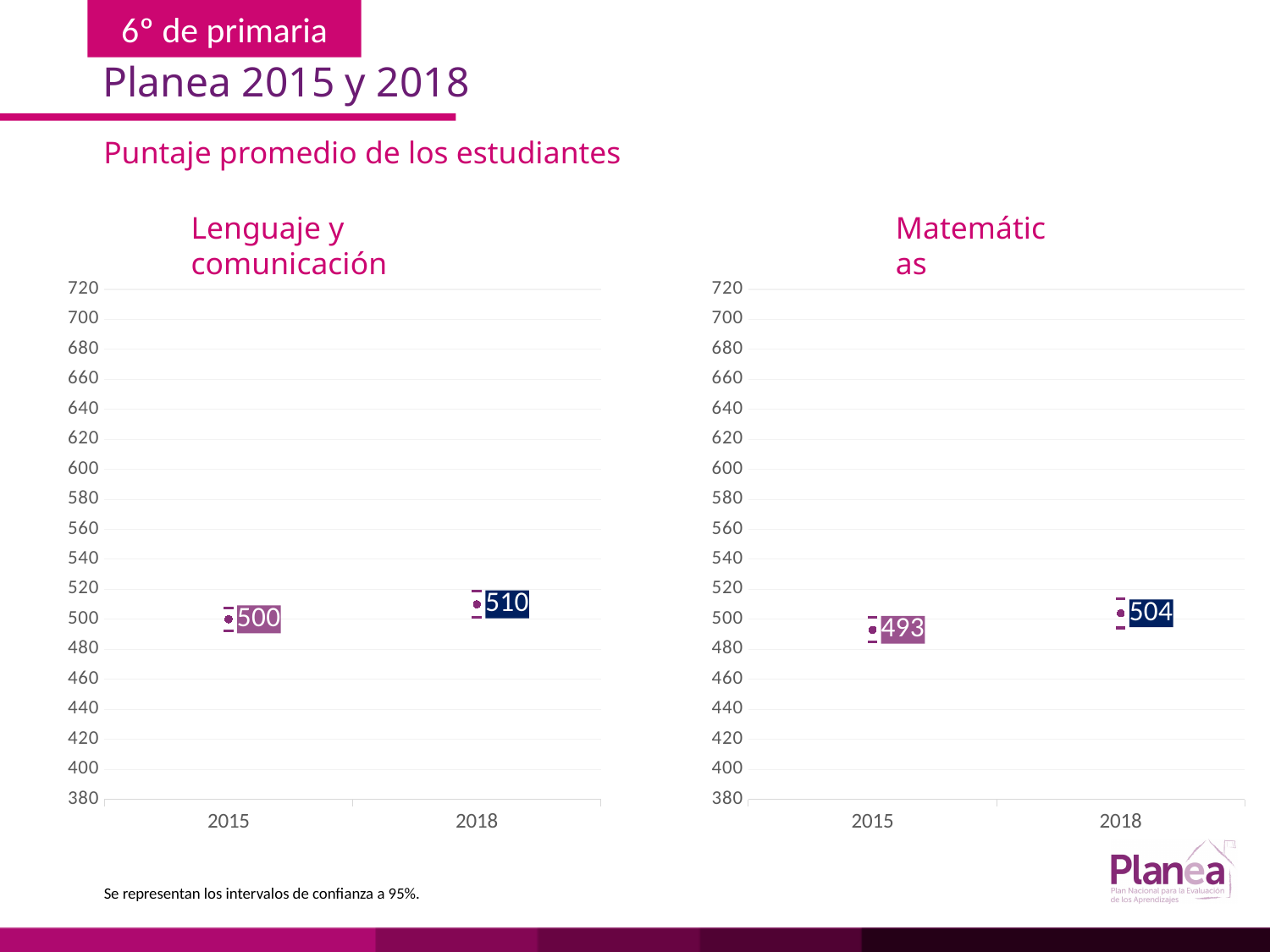
In the 'Matemáticas' chart, what is the difference between the 2018 and 2015 scores? 11 What is the maximum value shown on the y axis of the 'Matemáticas' chart? 720 In the 'Matemáticas' chart, which year has the higher score, 2015 or 2018? 2018 In the 'Matemáticas' chart, what is the average score for 2018? 504 In the 'Lenguaje y comunicación' chart, what is the average score for 2018? 510 In the 'Matemáticas' chart, do the scores rise or fall from 2015 to 2018? rise In the 'Matemáticas' chart, what is the average score for 2015? 493 In the 'Matemáticas' chart, is the 2015 score greater or less than 500? less How many years are plotted on the x axis of the 'Lenguaje y comunicación' chart? 2 In the 'Lenguaje y comunicación' chart, by how many points did the score change from 2015 to 2018? 10 In the 'Lenguaje y comunicación' chart, which year has the lowest score? 2015 In the 'Lenguaje y comunicación' chart, what is the average score for 2015? 500